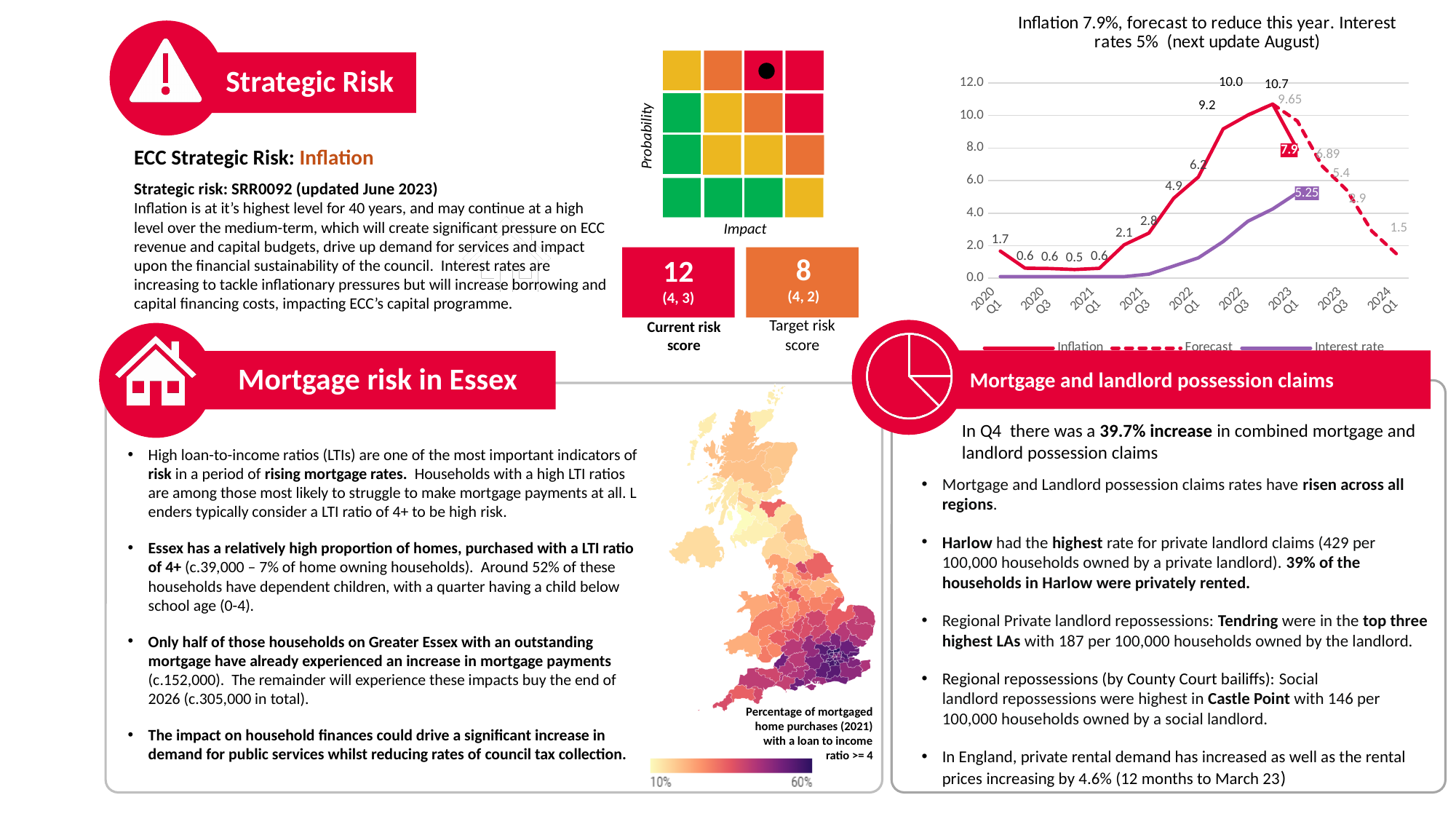
In the line chart, is the interest rate at 2022 Q1 greater or less than 2.0? less How many series does the legend of the line chart list? 3 In the line chart, what is the difference between the peak inflation value of 10.7 and the latest inflation value of 7.9? 2.8 What type of chart is shown in the top-right of the slide? line chart In the line chart, does the forecast line rise or fall from 2023 Q1 to 2024 Q1? fall In the line chart, what is the highest labelled inflation value? 10.7 How many x-axis labels are shown on the line chart? 9 In the line chart, which labelled inflation value is larger: 9.2 or 6.2? 9.2 What are the three legend entries of the line chart? Inflation, Forecast, Interest rate In the line chart, what is the final labelled value of the forecast line at 2024 Q1? 1.5 In the line chart, what value is labelled on the interest rate line at its highest point? 5.25 In the line chart, what is the inflation value labelled at 2020 Q1? 1.7